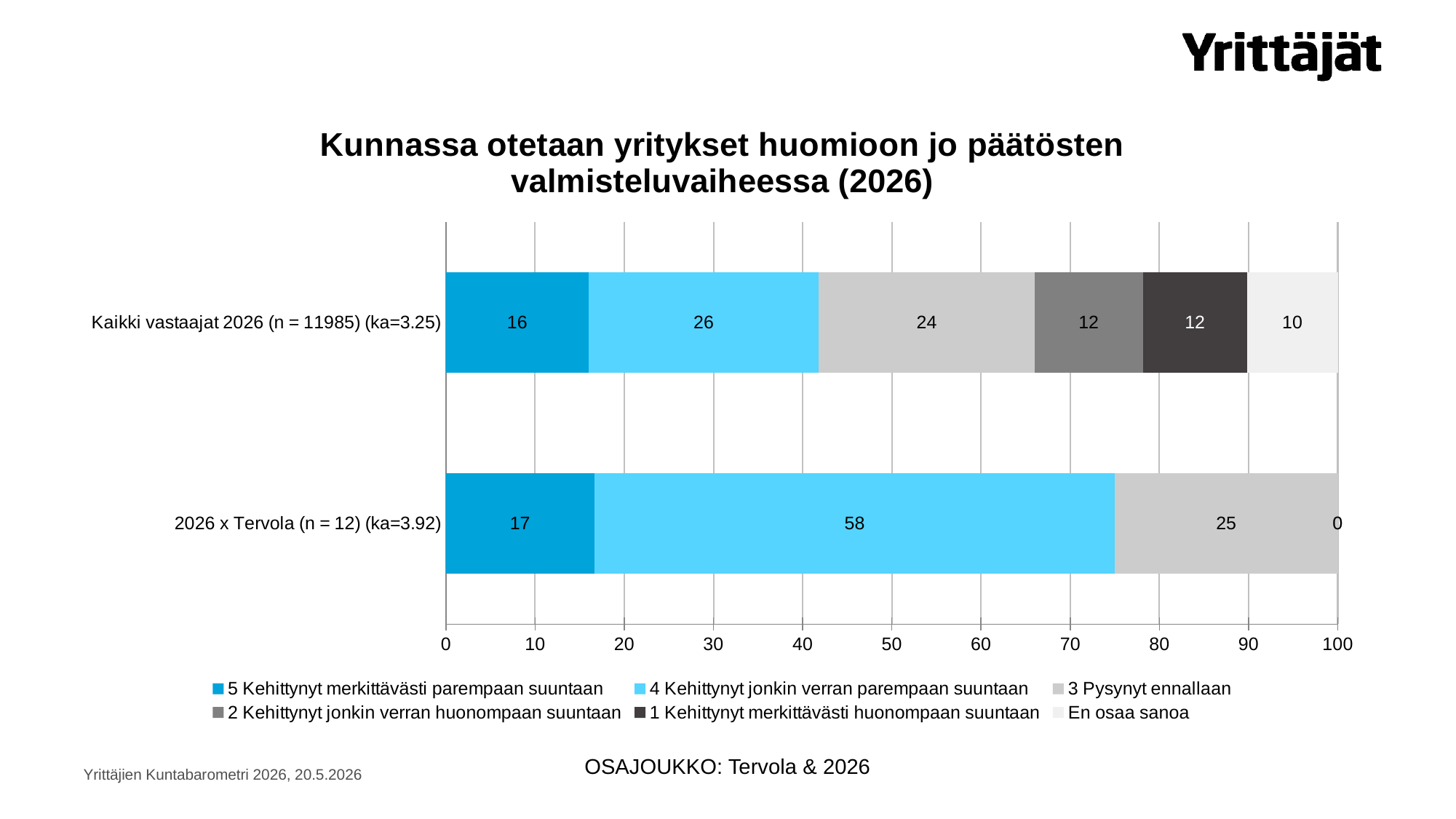
How many categories (bars) does the chart show? 2 Which segment is the largest in the '2026 x Tervola (n = 12) (ka=3.92)' bar? 4 Kehittynyt jonkin verran parempaan suuntaan What is the value of 'En osaa sanoa' for 'Kaikki vastaajat 2026 (n = 11985) (ka=3.25)'? 10 What is the value of '3 Pysynyt ennallaan' for 'Kaikki vastaajat 2026 (n = 11985) (ka=3.25)'? 24 What is the value of '5 Kehittynyt merkittävästi parempaan suuntaan' for 'Kaikki vastaajat 2026 (n = 11985) (ka=3.25)'? 16 How many series does the legend list? 6 What is the difference between the '4 Kehittynyt jonkin verran parempaan suuntaan' values for '2026 x Tervola' and 'Kaikki vastaajat 2026'? 32 What is the title of the chart? Kunnassa otetaan yritykset huomioon jo päätösten valmisteluvaiheessa (2026) What is the value of '3 Pysynyt ennallaan' for '2026 x Tervola (n = 12) (ka=3.92)'? 25 What is the value of '4 Kehittynyt jonkin verran parempaan suuntaan' for '2026 x Tervola (n = 12) (ka=3.92)'? 58 What kind of chart is shown on the slide? Stacked bar chart Which category has the larger value for '4 Kehittynyt jonkin verran parempaan suuntaan': 'Kaikki vastaajat 2026' or '2026 x Tervola'? 2026 x Tervola